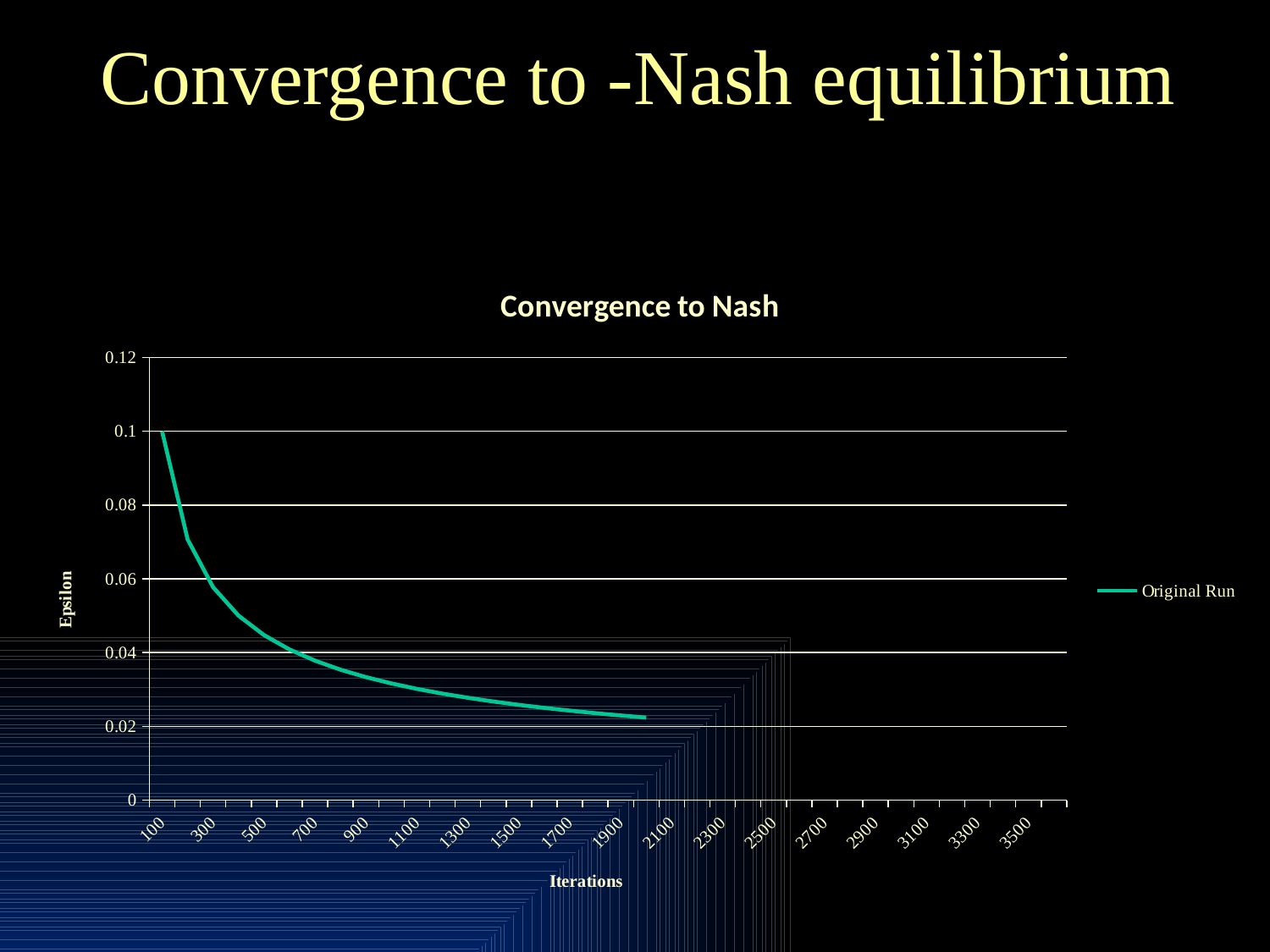
At which iteration count is the Epsilon value highest? 100 What kind of chart is shown on the slide? line chart Is the Epsilon value at 500 iterations greater or less than 0.04? greater What is the Epsilon value of the Original Run at 100 iterations? 0.1 Is the Epsilon value at 1900 iterations greater or less than 0.02? greater Which has the larger Epsilon value, 500 iterations or 1500 iterations? 500 iterations Is the Epsilon value at 1100 iterations greater or less than 0.04? less What is the name of the series shown in the legend? Original Run Do the Epsilon values rise or fall as Iterations increase along the x axis? fall What is the title of the chart? Convergence to Nash How many series does the legend list? 1